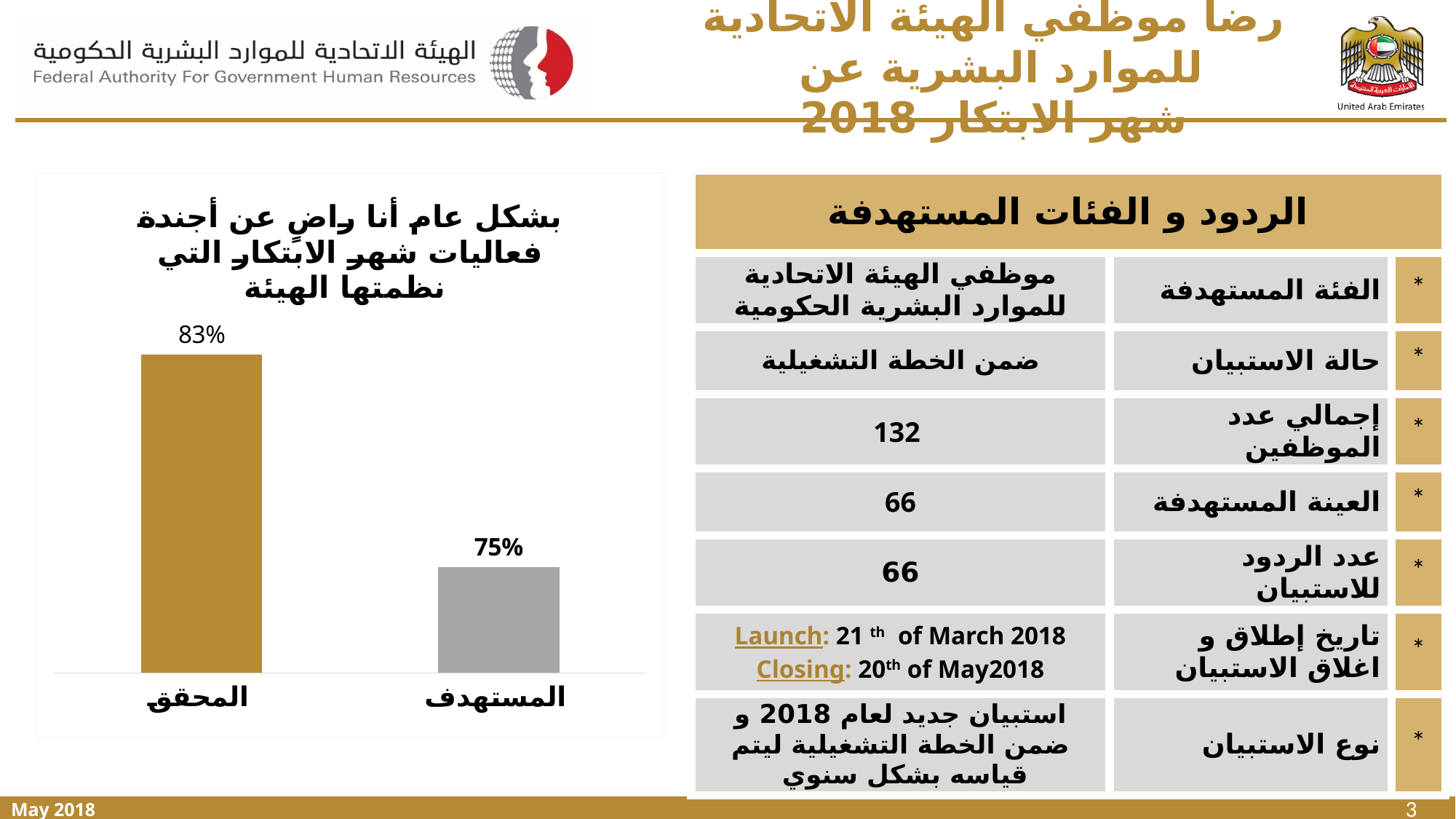
Which category has the highest value in the bar chart? المحقق How many categories are shown in the bar chart? 2 Do the values in the bar chart rise or fall from the left bar to the right bar? Fall What kind of chart is shown on the slide? Bar chart What colour is the bar for المحقق in the bar chart? Gold Which is larger in the bar chart, the value for المحقق or the value for المستهدف? المحقق What is the difference between the values for المحقق and المستهدف in the bar chart? 8% What colour is the bar for المستهدف in the bar chart? Grey What is the value for المستهدف in the bar chart? 75% What is the value for المحقق in the bar chart? 83% Which category has the lowest value in the bar chart? المستهدف